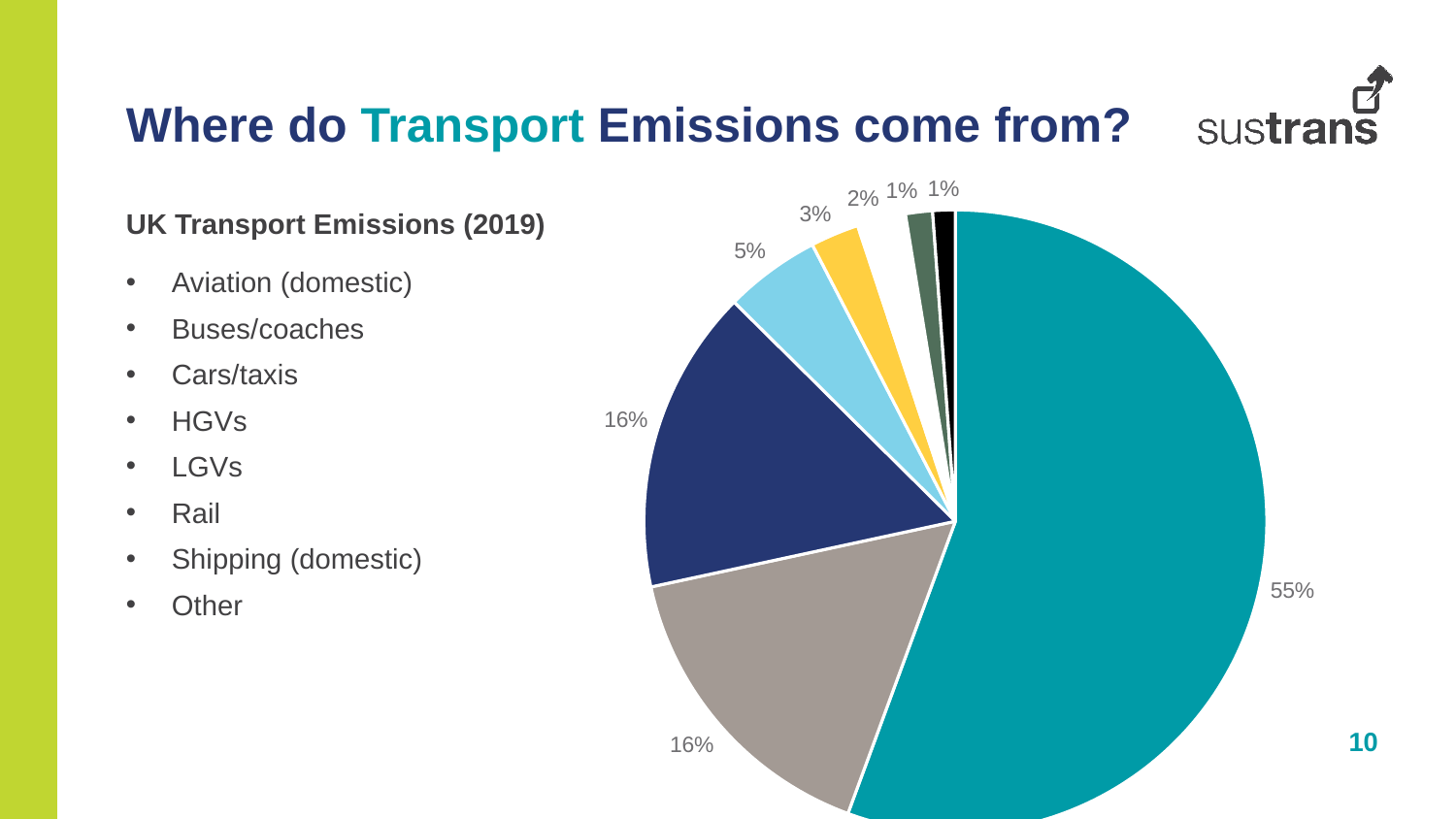
What is the difference in percentage points between the largest slice (55%) and the grey slice (16%)? 39 What percentage is labelled on the grey slice of the pie chart? 16% What percentage is labelled on the large teal slice of the pie chart? 55% What kind of chart is shown on the slide? pie chart What is the title given above the list of categories on the slide? UK Transport Emissions (2019) What percentage is labelled on the yellow slice of the pie chart? 3% How many slices does the pie chart have? 8 What percentage is labelled on the light blue slice of the pie chart? 5% How many slices of the pie chart are labelled 1%? 2 What is the smallest percentage shown on the pie chart? 1% Which slice is larger, the light blue slice or the yellow slice? the light blue slice What is the largest percentage shown on the pie chart? 55%